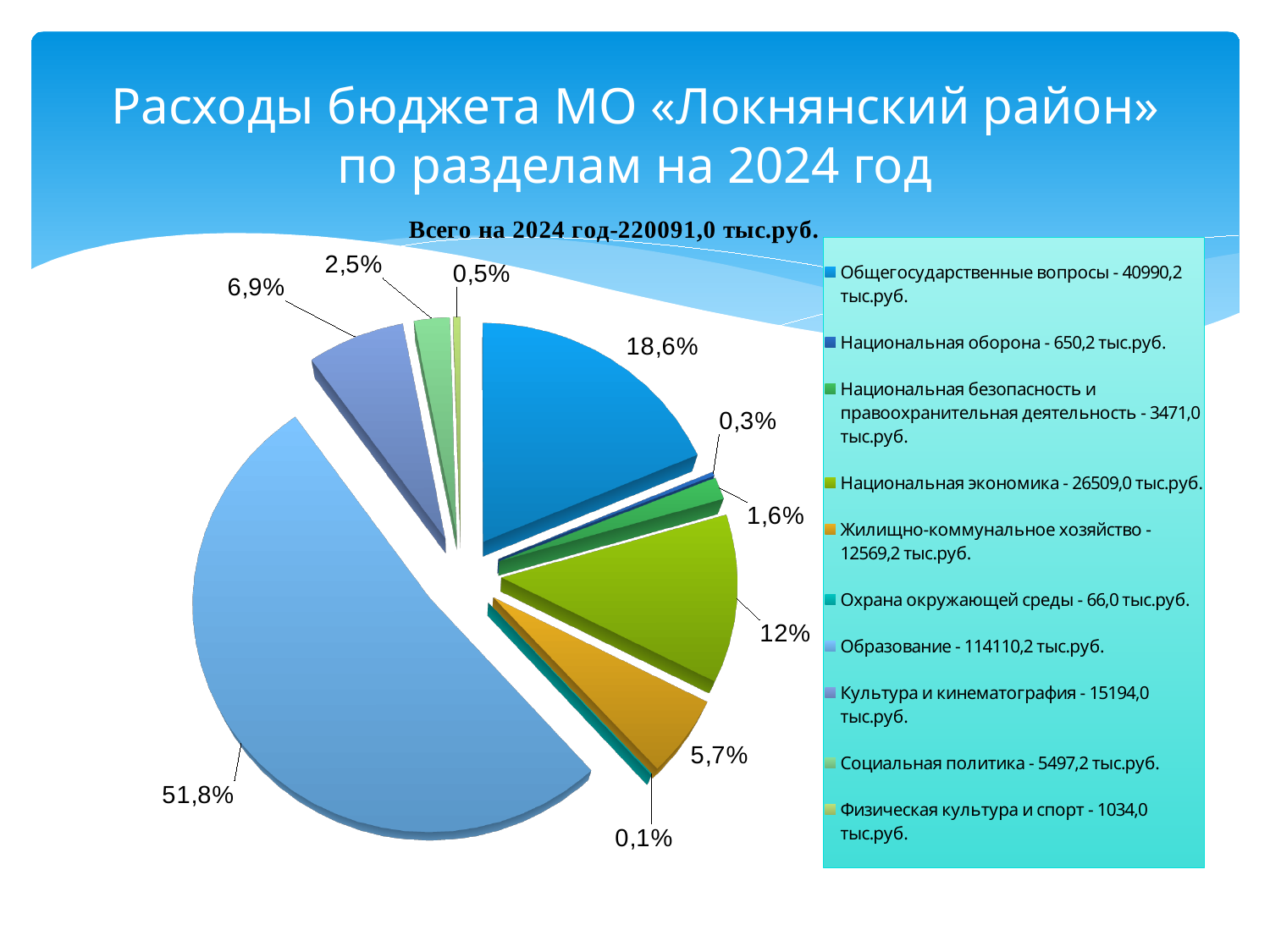
What kind of chart is shown on the slide? pie chart What share of the pie does Общегосударственные вопросы take? 18,6% Which category has the largest slice of the pie? Образование What share of the pie does Национальная экономика take? 12% What share of the pie does Образование take? 51,8% Which category has the smallest slice of the pie? Охрана окружающей среды According to the legend, what is the amount for Национальная оборона? 650,2 тыс.руб. What is the difference in percentage points between the Образование slice and the Общегосударственные вопросы slice? 33,2 What total amount for 2024 is stated above the chart? 220091,0 тыс.руб. How many categories does the legend of the pie chart list? 10 Which is larger: the slice for Культура и кинематография or the slice for Жилищно-коммунальное хозяйство? Культура и кинематография According to the legend, what is the amount for Социальная политика? 5497,2 тыс.руб.